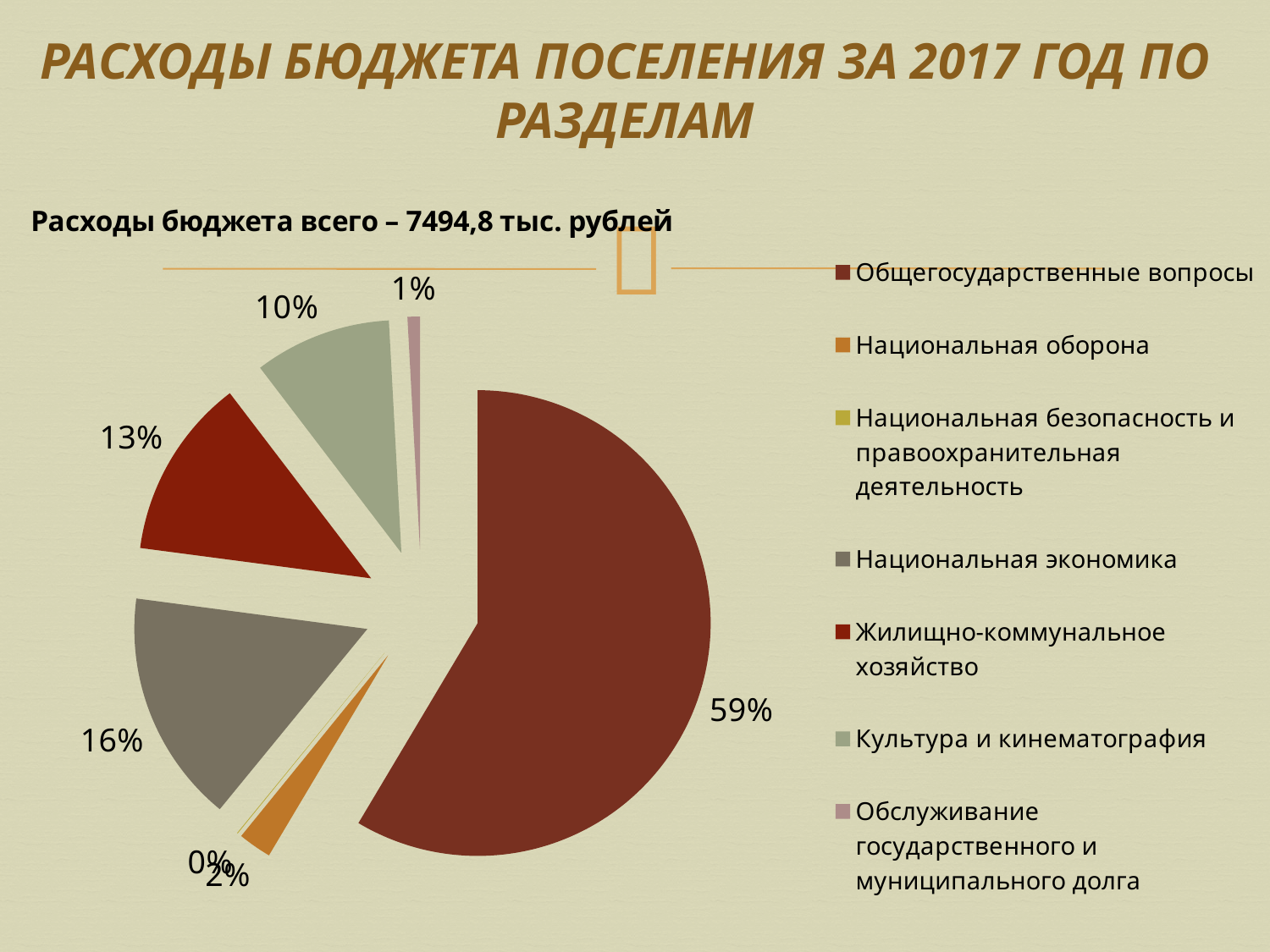
What share of the pie does Жилищно-коммунальное хозяйство take? 13% What share of the pie does Национальная оборона take? 2% What share of the pie does Обслуживание государственного и муниципального долга take? 1% What kind of chart is shown on the slide? pie chart Which is larger, the slice for Национальная экономика or the slice for Жилищно-коммунальное хозяйство? Национальная экономика Which category has the largest slice of the pie? Общегосударственные вопросы How many categories does the legend of the pie chart list? 7 What total budget expenditure is stated above the chart? 7494,8 тыс. рублей What is the difference in percentage points between the Общегосударственные вопросы slice and the Национальная экономика slice? 43